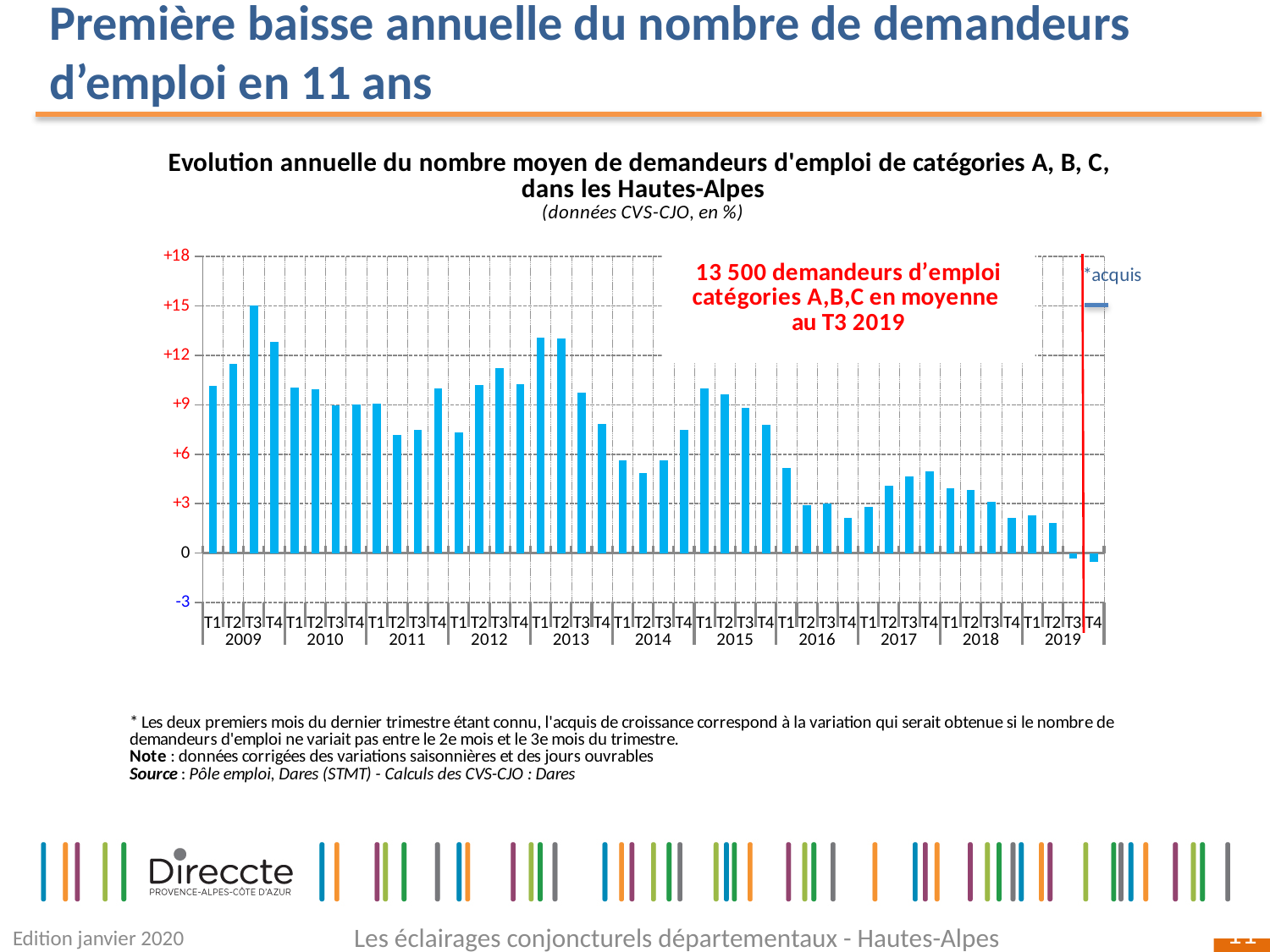
Which quarter has the highest value in the chart? T3 2009 What kind of chart is shown on the slide? bar chart Is the value for T1 2015 greater or less than +9? greater Which is larger, the value for T1 2009 or the value for T1 2016? T1 2009 Do the values generally rise or fall from 2015 to 2019? fall Is the value for T4 2016 greater or less than +3? less Is the value for T3 2019 greater or less than 0? less What does the red annotation on the chart say? 13 500 demandeurs d'emploi catégories A,B,C en moyenne au T3 2019 What is the title of the chart? Evolution annuelle du nombre moyen de demandeurs d'emploi de catégories A, B, C, dans les Hautes-Alpes How many years are shown on the x axis of the chart? 11